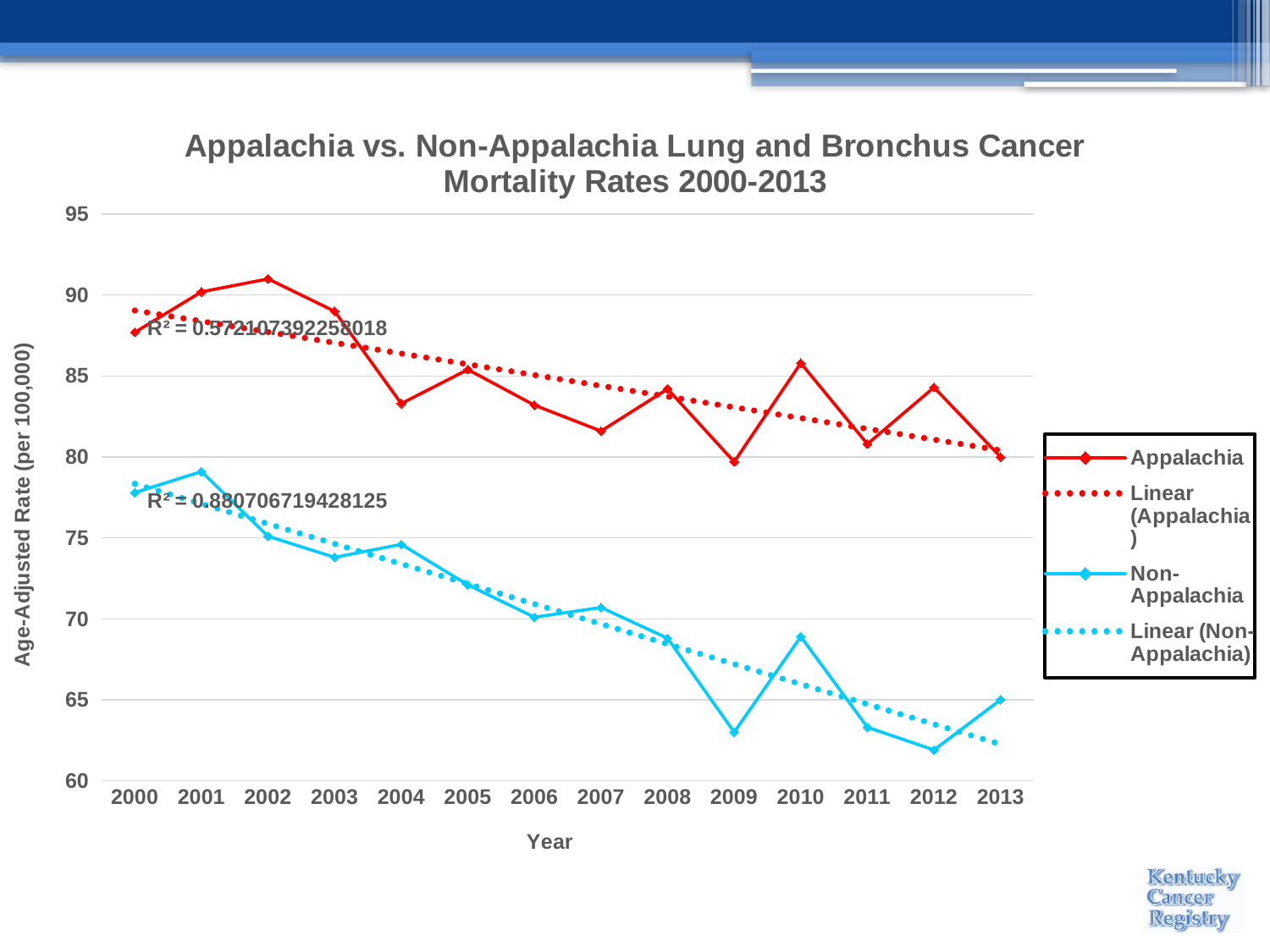
Is the Appalachia value for 2002 greater or less than 90? greater Do the Non-Appalachia values generally rise or fall from 2000 to 2013? Fall What kind of chart is shown on the slide? Line chart In which year is the Non-Appalachia rate highest? 2001 What is the title of the chart? Appalachia vs. Non-Appalachia Lung and Bronchus Cancer Mortality Rates 2000-2013 How many years are plotted along the x axis? 14 Is the Non-Appalachia value for 2009 greater or less than 65? less In which year is the Non-Appalachia rate lowest? 2012 In 2010, which series has the larger value, Appalachia or Non-Appalachia? Appalachia What is the label of the vertical axis? Age-Adjusted Rate (per 100,000) In which year is the Appalachia rate highest? 2002 How many entries does the legend list? 4